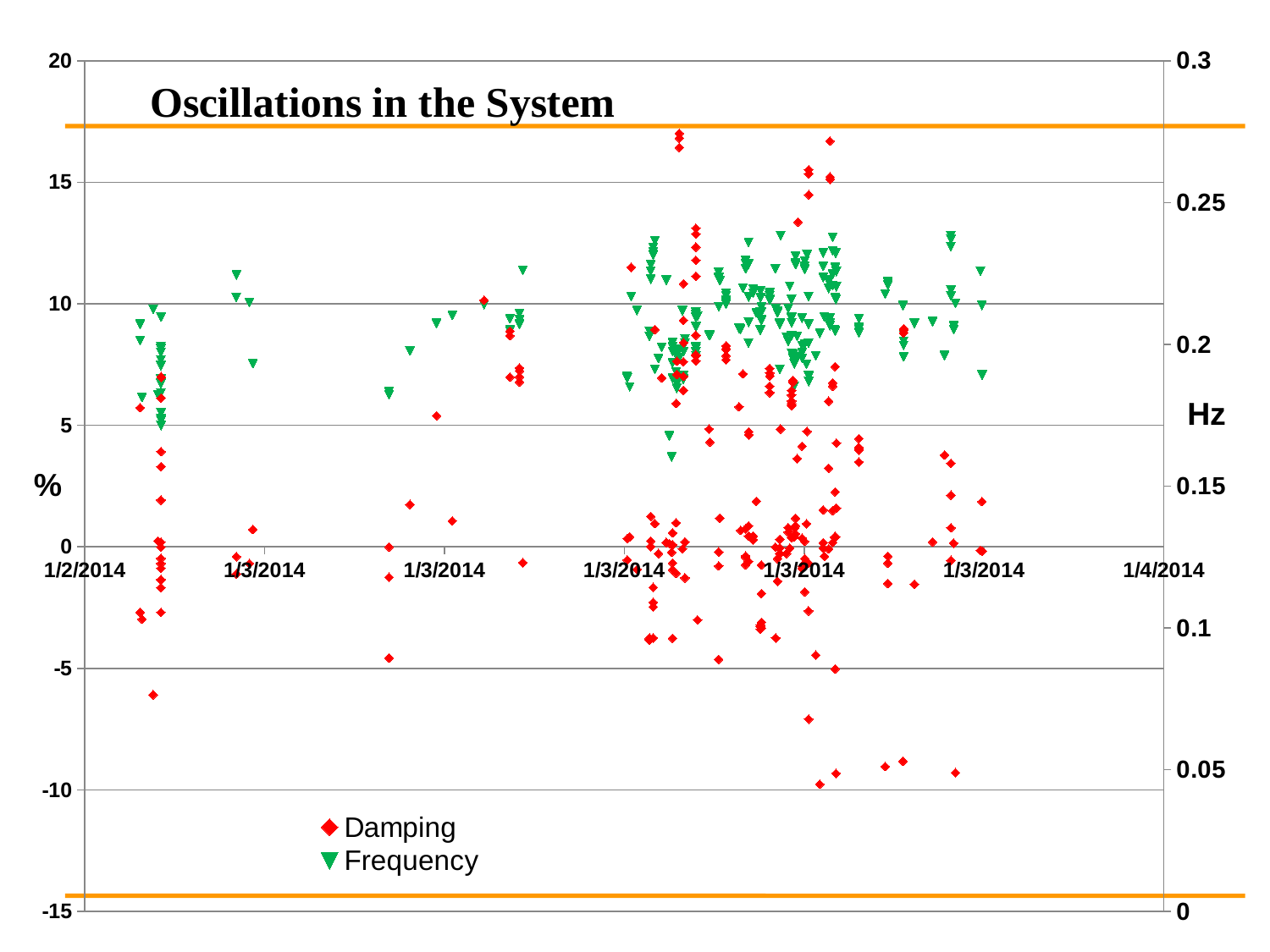
Is the lowest Damping value greater or less than -5? less Is the highest Damping value greater or less than 20? less Is the lowest Damping value greater or less than -15? greater What kind of chart is shown on the slide? scatter chart Which series is plotted with red diamond markers? Damping What is the title of the chart? Oscillations in the System How many series does the legend list? 2